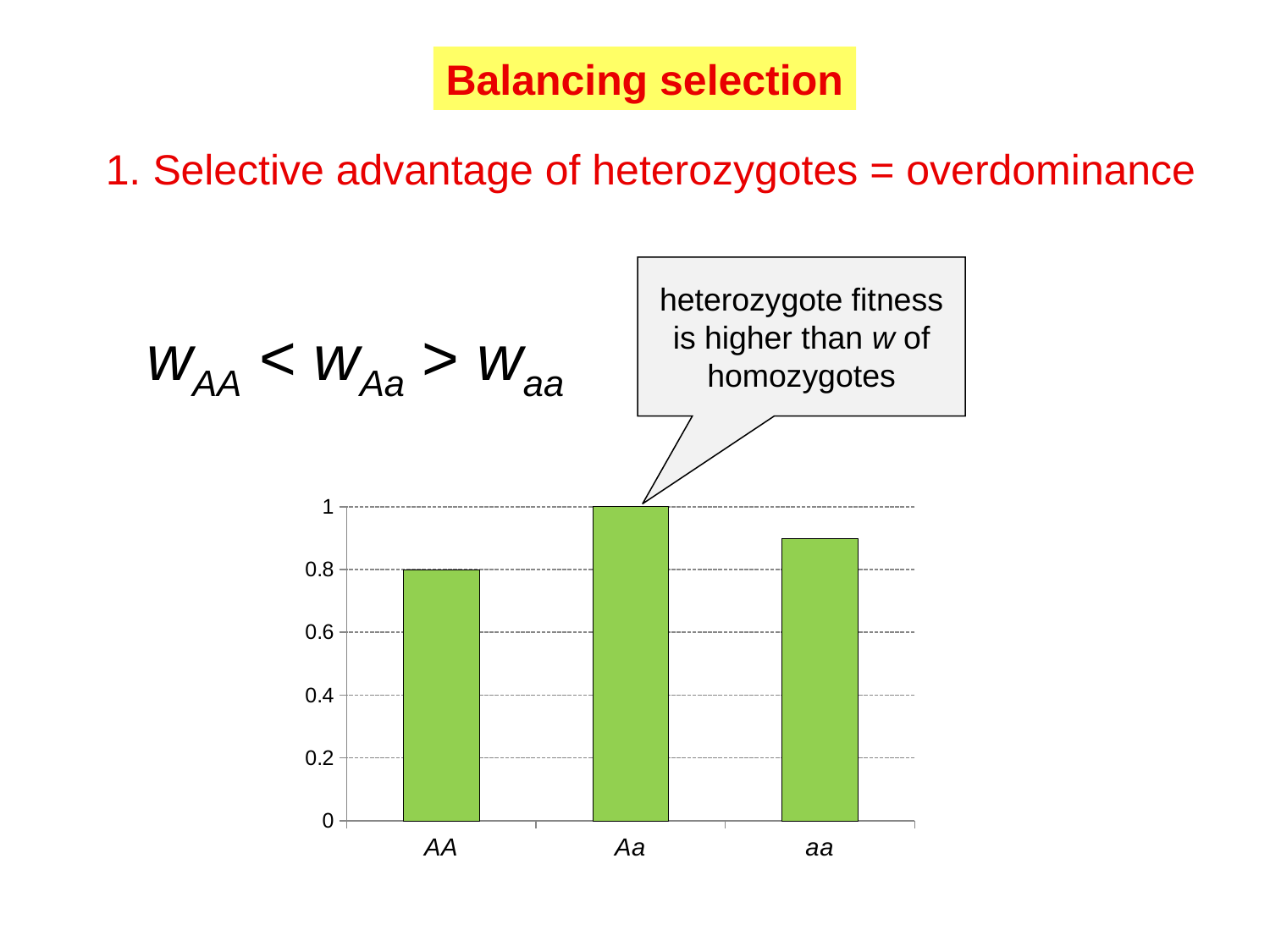
What colour are the bars in the chart? green What type of chart is shown on the slide? bar chart How many genotype categories are plotted on the x axis? 3 What is the value of the bar for AA? 0.8 Is the value for aa greater or less than 0.8? greater What is the difference between the bars for Aa and AA? 0.2 Which genotype has the highest bar? Aa Is the value for aa greater or less than 1? less Which genotype has the lowest bar? AA Which bar is taller, Aa or aa? Aa